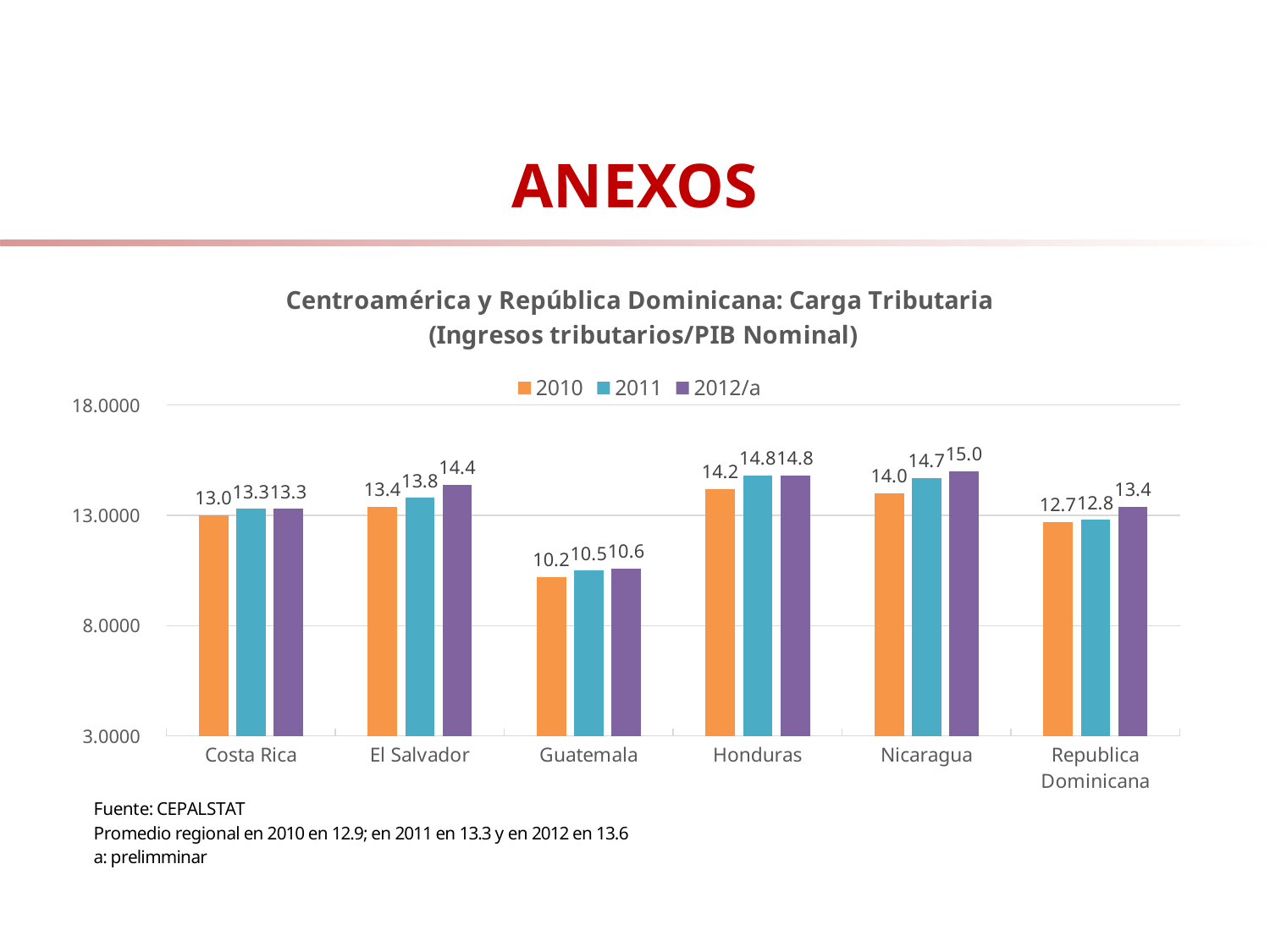
What is the difference between the 2012/a and 2010 values for El Salvador? 1.0 What is the value for Republica Dominicana in 2011? 12.8 Which country has the lowest value in 2010? Guatemala What kind of chart is shown? Bar chart Which is larger, the 2011 value for Honduras or the 2011 value for Nicaragua? Honduras How many series does the legend list? 3 What is the value for Nicaragua in 2012/a? 15.0 What is the title of the chart? Centroamérica y República Dominicana: Carga Tributaria (Ingresos tributarios/PIB Nominal) How many countries are shown on the x axis? 6 Which country has the highest value in 2012/a? Nicaragua What is the value for Guatemala in 2010? 10.2 Do the values for Costa Rica rise or fall from 2010 to 2012/a? Rise